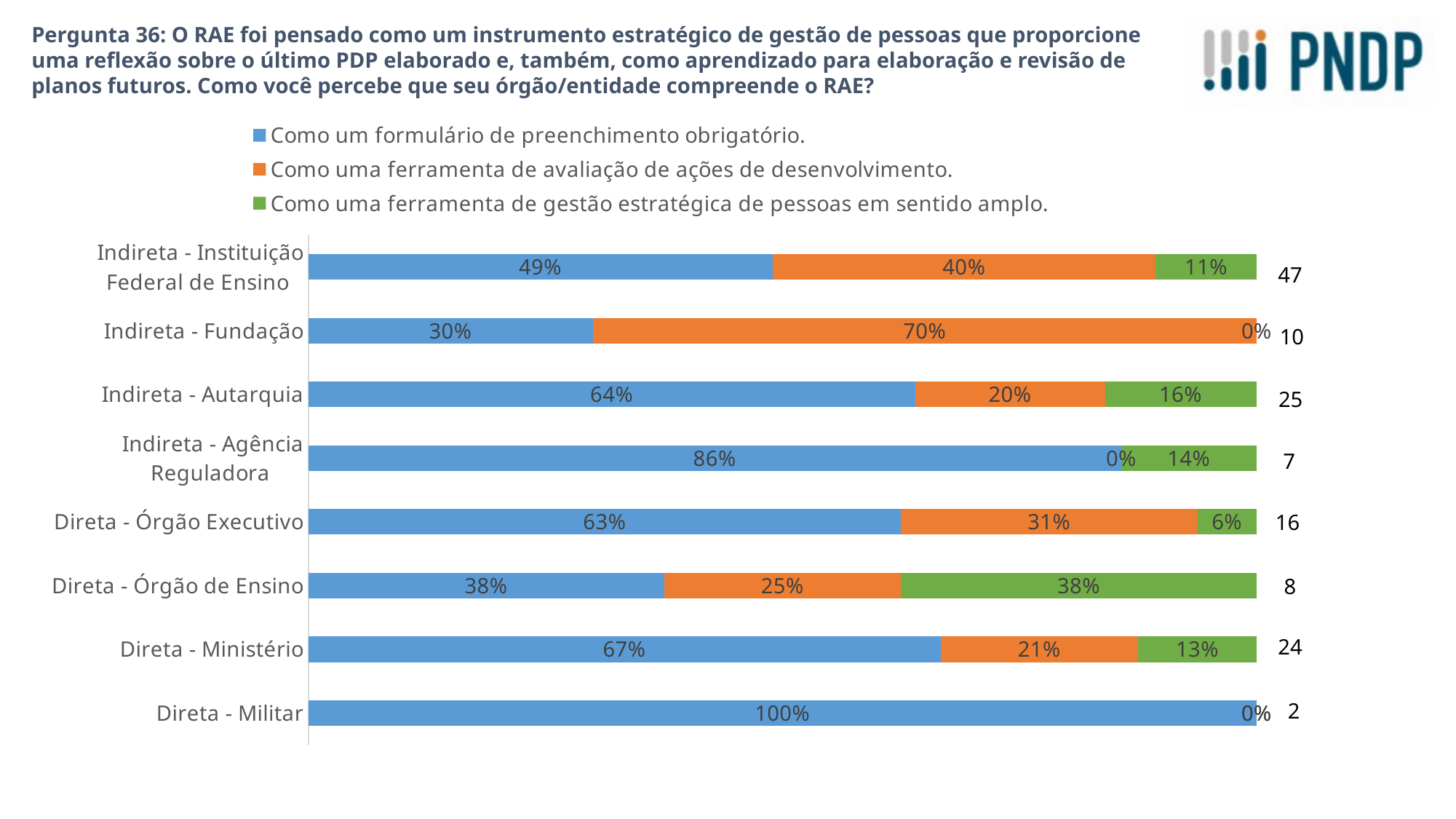
Which is larger: the 'Como uma ferramenta de avaliação de ações de desenvolvimento' share for 'Indireta - Instituição Federal de Ensino' or for 'Direta - Órgão Executivo'? Indireta - Instituição Federal de Ensino What percentage of 'Indireta - Agência Reguladora' respondents see the RAE 'Como um formulário de preenchimento obrigatório'? 86% What kind of chart is shown on the slide? Stacked bar chart What colour represents 'Como uma ferramenta de gestão estratégica de pessoas em sentido amplo' in the chart? Green How many series does the legend list? 3 Which category has the highest share for 'Como um formulário de preenchimento obrigatório'? Direta - Militar How many categories (órgão/entidade types) are shown on the chart? 8 Which category has the lowest share for 'Como um formulário de preenchimento obrigatório'? Indireta - Fundação What is the difference between the 'Como um formulário de preenchimento obrigatório' shares of 'Direta - Ministério' and 'Indireta - Autarquia'? 3% What number is printed at the right end of the 'Indireta - Instituição Federal de Ensino' bar? 47 What percentage of 'Direta - Órgão de Ensino' respondents see the RAE 'Como uma ferramenta de gestão estratégica de pessoas em sentido amplo'? 38% What percentage of 'Indireta - Fundação' respondents see the RAE 'Como uma ferramenta de avaliação de ações de desenvolvimento'? 70%